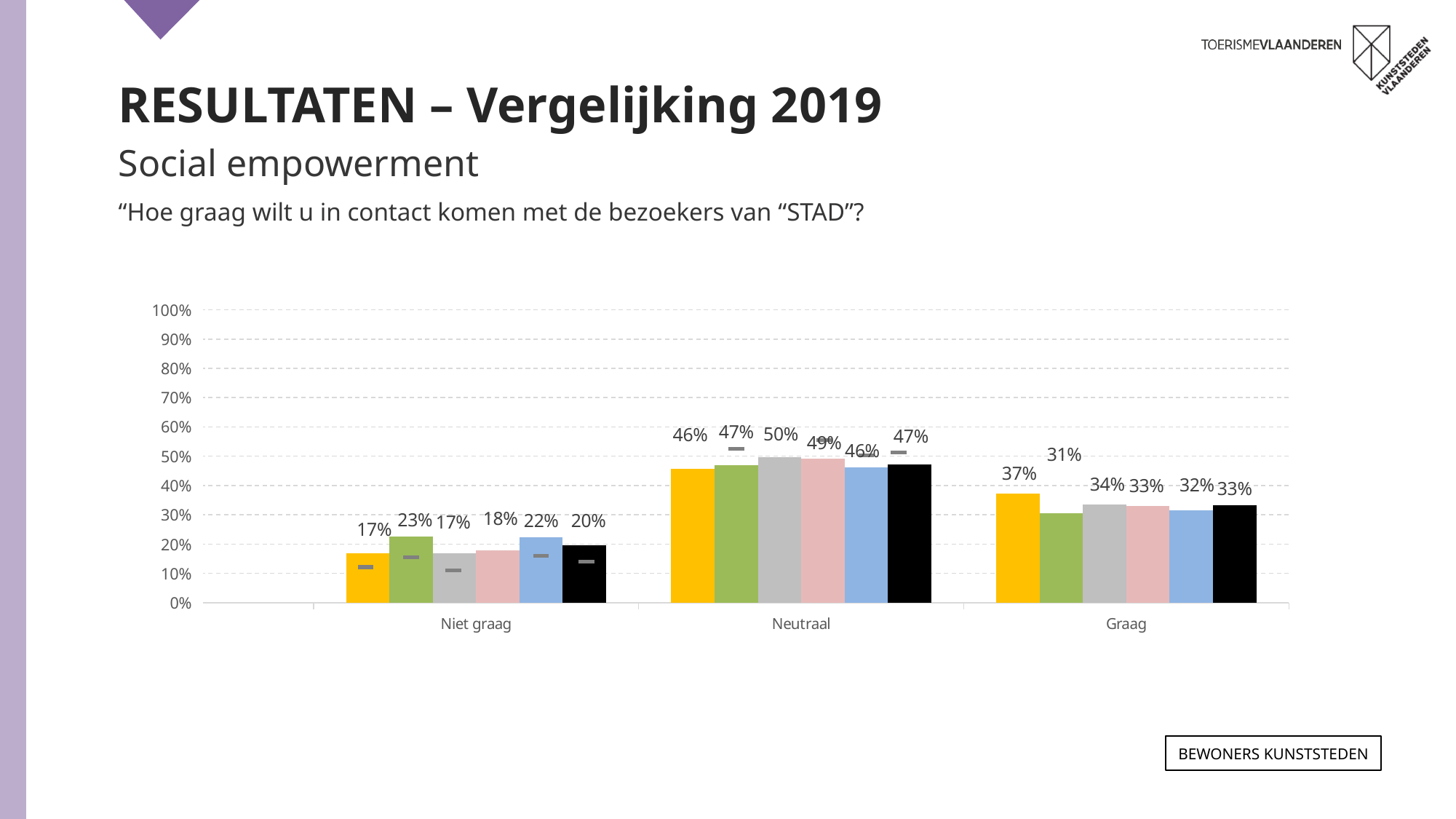
Which category on the x axis has the highest values overall? Neutraal Which bar is the lowest in the 'Graag' category? the green bar (31%) Which bar is the highest in the 'Neutraal' category? the grey bar (50%) What is the difference between the yellow bar and the green bar in the 'Graag' category? 6% What kind of chart is shown on the slide? bar chart How many bars are plotted in each category of the chart? 6 Which is larger in the 'Niet graag' category: the blue bar or the pink bar? the blue bar (22%) What is the value of the green bar in the 'Niet graag' category? 23% What is the value of the black bar in the 'Graag' category? 33% What is the value of the grey bar in the 'Neutraal' category? 50% What is the value of the yellow bar in the 'Graag' category? 37% How many categories are shown on the x axis of the chart? 3